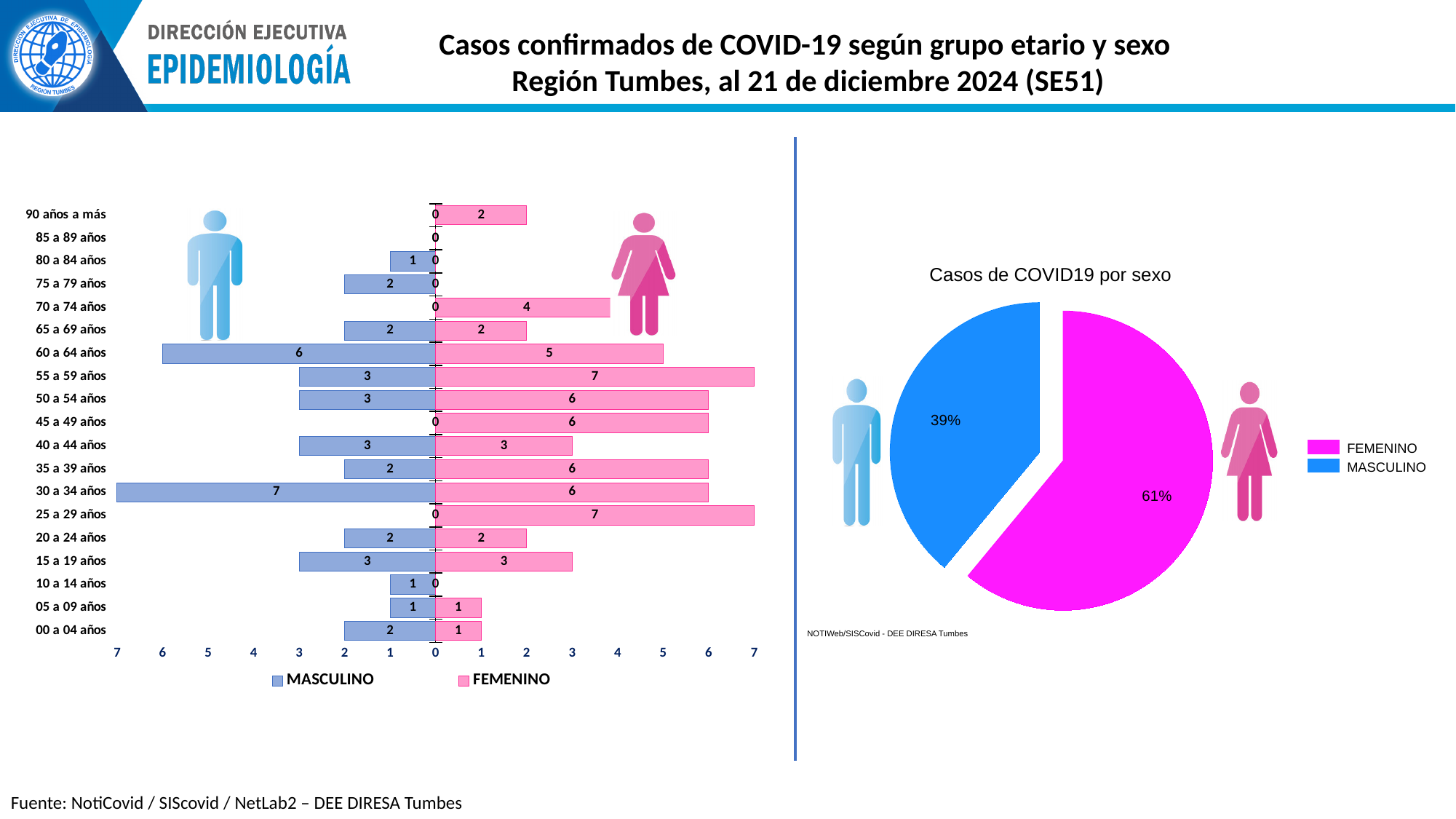
In the pie chart 'Casos de COVID19 por sexo', what share of cases is MASCULINO? 39% What kind of chart is the left chart showing cases by age group and sex? Bar chart In the pie chart 'Casos de COVID19 por sexo', what share of cases is FEMENINO? 61% In the left chart (cases by age group and sex), which age group has the highest number of MASCULINO cases? 30 a 34 años In the left chart (cases by age group and sex), how many age groups are shown? 19 In the pie chart 'Casos de COVID19 por sexo', what colour represents MASCULINO? Blue In the left chart (cases by age group and sex), how many FEMENINO cases are in the 55 a 59 años group? 7 In the left chart (cases by age group and sex), what is the difference between FEMENINO and MASCULINO cases in the 50 a 54 años group? 3 In the left chart (cases by age group and sex), how many MASCULINO cases are in the 30 a 34 años group? 7 In the left chart (cases by age group and sex), how many series does the legend list? 2 In the left chart (cases by age group and sex), which is larger in the 60 a 64 años group, MASCULINO or FEMENINO? MASCULINO In the left chart (cases by age group and sex), how many FEMENINO cases are in the 70 a 74 años group? 4